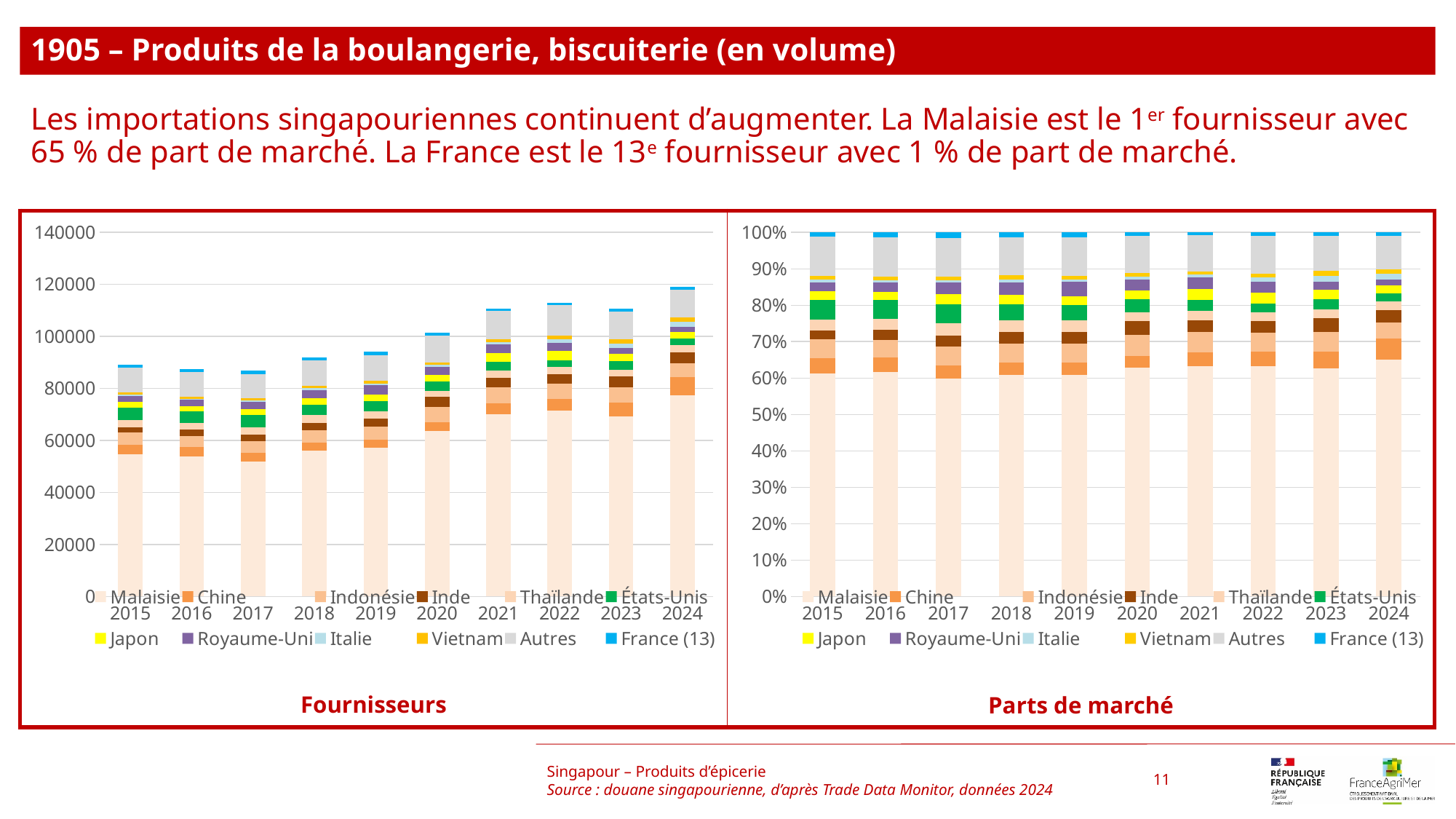
Which legend entry in the 'Fournisseurs' chart is shown in light blue and includes a rank in parentheses? France (13) How many series does the legend of the 'Parts de marché' chart list? 12 In the 'Fournisseurs' chart, is the total for 2015 greater or less than 100000? less In the 'Parts de marché' chart, is the share of Malaisie in 2015 greater or less than 50%? greater How many years are shown on the x axis of the 'Fournisseurs' chart? 10 In the 'Fournisseurs' chart, is the total for 2024 greater or less than 100000? greater In the 'Fournisseurs' chart, do the total imports generally rise or fall from 2015 to 2024? rise In the 'Fournisseurs' chart, which total is larger, 2015 or 2024? 2024 What kind of chart is the 'Fournisseurs' chart on the left? stacked bar chart In the 'Fournisseurs' chart, which year has the highest total stacked bar? 2024 What is the title shown under the right-hand chart? Parts de marché